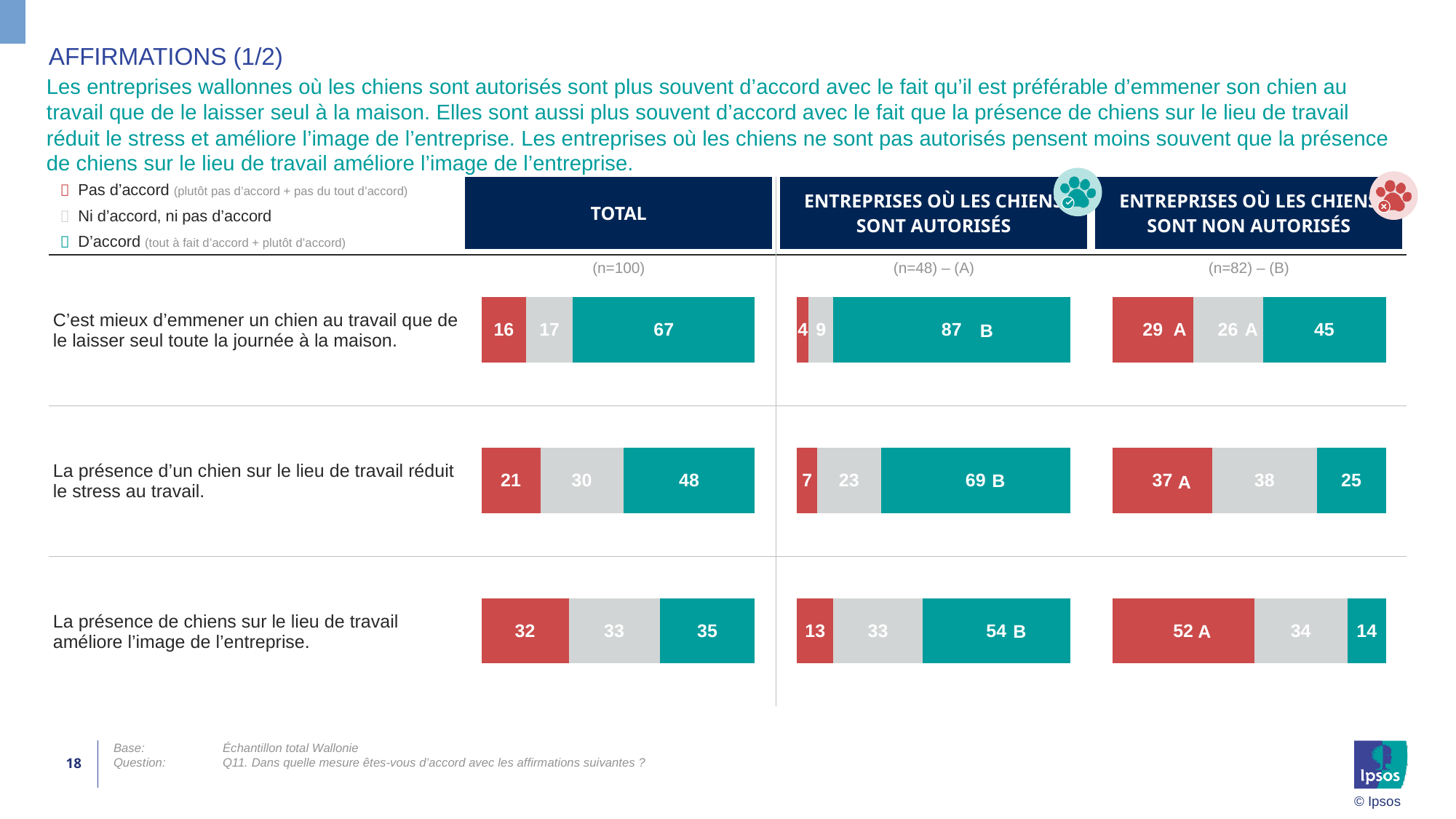
In the ENTREPRISES OÙ LES CHIENS SONT AUTORISÉS chart, what is the 'D'accord' value for 'La présence d'un chien sur le lieu de travail réduit le stress au travail'? 69 What is the sample size (n) shown for the ENTREPRISES OÙ LES CHIENS SONT NON AUTORISÉS chart? n=82 How many series does the legend list? 3 In the TOTAL chart, which statement has the highest 'D'accord' value? C'est mieux d'emmener un chien au travail que de le laisser seul toute la journée à la maison. In the ENTREPRISES OÙ LES CHIENS SONT NON AUTORISÉS chart, what is the 'Pas d'accord' value for 'La présence de chiens sur le lieu de travail améliore l'image de l'entreprise'? 52 In the TOTAL chart, what is the 'D'accord' value for the statement 'C'est mieux d'emmener un chien au travail que de le laisser seul toute la journée à la maison'? 67 In the ENTREPRISES OÙ LES CHIENS SONT AUTORISÉS chart, what is the 'Ni d'accord, ni pas d'accord' value for 'La présence de chiens sur le lieu de travail améliore l'image de l'entreprise'? 33 How many statements are shown in each chart? 3 What kind of chart is used to show the results? Stacked bar chart In the TOTAL chart, is the 'Pas d'accord' value or the 'D'accord' value larger for 'La présence de chiens sur le lieu de travail améliore l'image de l'entreprise'? D'accord What is the difference between the 'D'accord' values for 'C'est mieux d'emmener un chien au travail...' in the ENTREPRISES OÙ LES CHIENS SONT AUTORISÉS chart and the ENTREPRISES OÙ LES CHIENS SONT NON AUTORISÉS chart? 42 In the ENTREPRISES OÙ LES CHIENS SONT NON AUTORISÉS chart, which statement has the lowest 'D'accord' value? La présence de chiens sur le lieu de travail améliore l'image de l'entreprise.